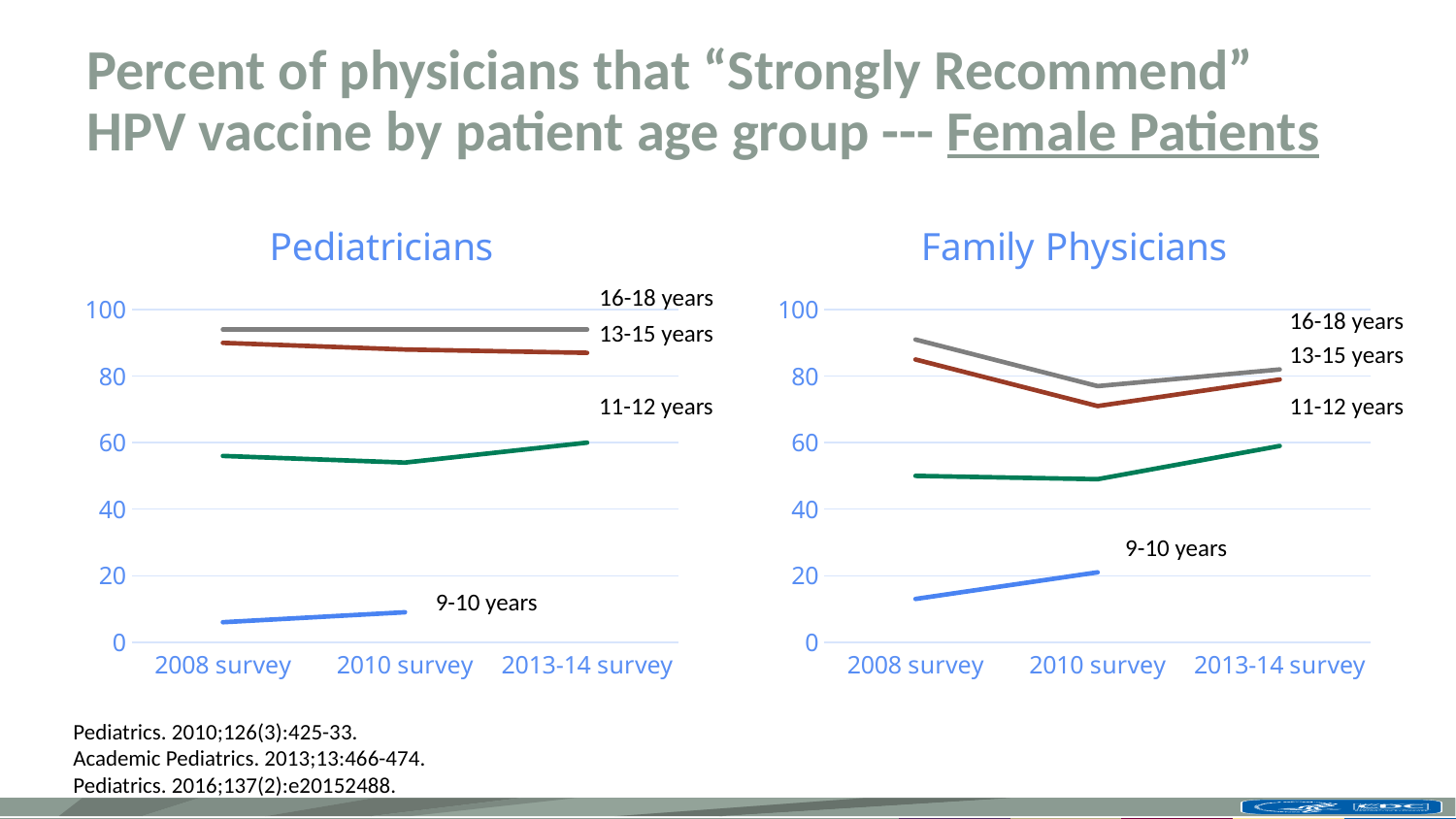
What kind of chart is the Pediatricians chart? line chart In the Family Physicians chart, does the 9-10 years line rise or fall from the 2008 survey to the 2010 survey? rise In the Family Physicians chart, which age group has the lowest values? 9-10 years In the Pediatricians chart, is the value for 16-18 years in the 2008 survey greater or less than 80? greater In the Pediatricians chart, which is larger in the 2008 survey: 16-18 years or 11-12 years? 16-18 years In the Family Physicians chart, is the value for 11-12 years in the 2008 survey greater or less than 60? less In the Pediatricians chart, is the value for 9-10 years in the 2008 survey greater or less than 20? less In the Pediatricians chart, which age group has the highest values? 16-18 years What is the title of the chart on the right side of the slide? Family Physicians How many age-group series are labelled on the Pediatricians chart? 4 How many survey years are shown on the x axis of the Family Physicians chart? 3